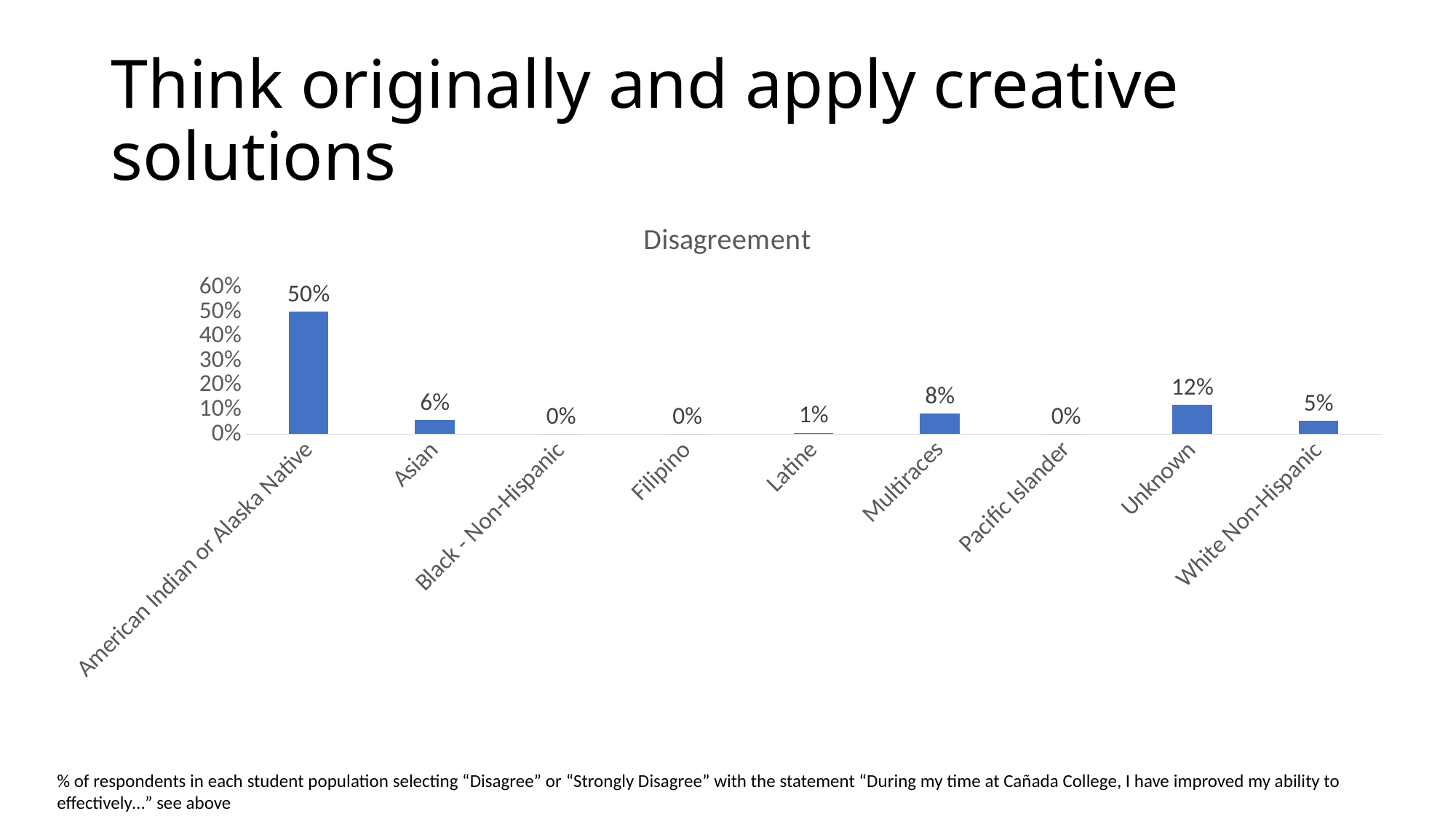
What is the difference between the disagreement values for Unknown and Asian? 6% What is the title of the chart? Disagreement What kind of chart is shown on the slide? Bar chart What is the disagreement value for American Indian or Alaska Native? 50% Which has a larger disagreement value, Multiraces or White Non-Hispanic? Multiraces Which category has the highest disagreement value? American Indian or Alaska Native Which has a larger disagreement value, Asian or Unknown? Unknown What is the disagreement value for Multiraces? 8% What is the disagreement value for Unknown? 12% How many categories are shown on the x axis of the chart? 9 What is the difference between the disagreement values for American Indian or Alaska Native and Multiraces? 42% What is the disagreement value for White Non-Hispanic? 5%